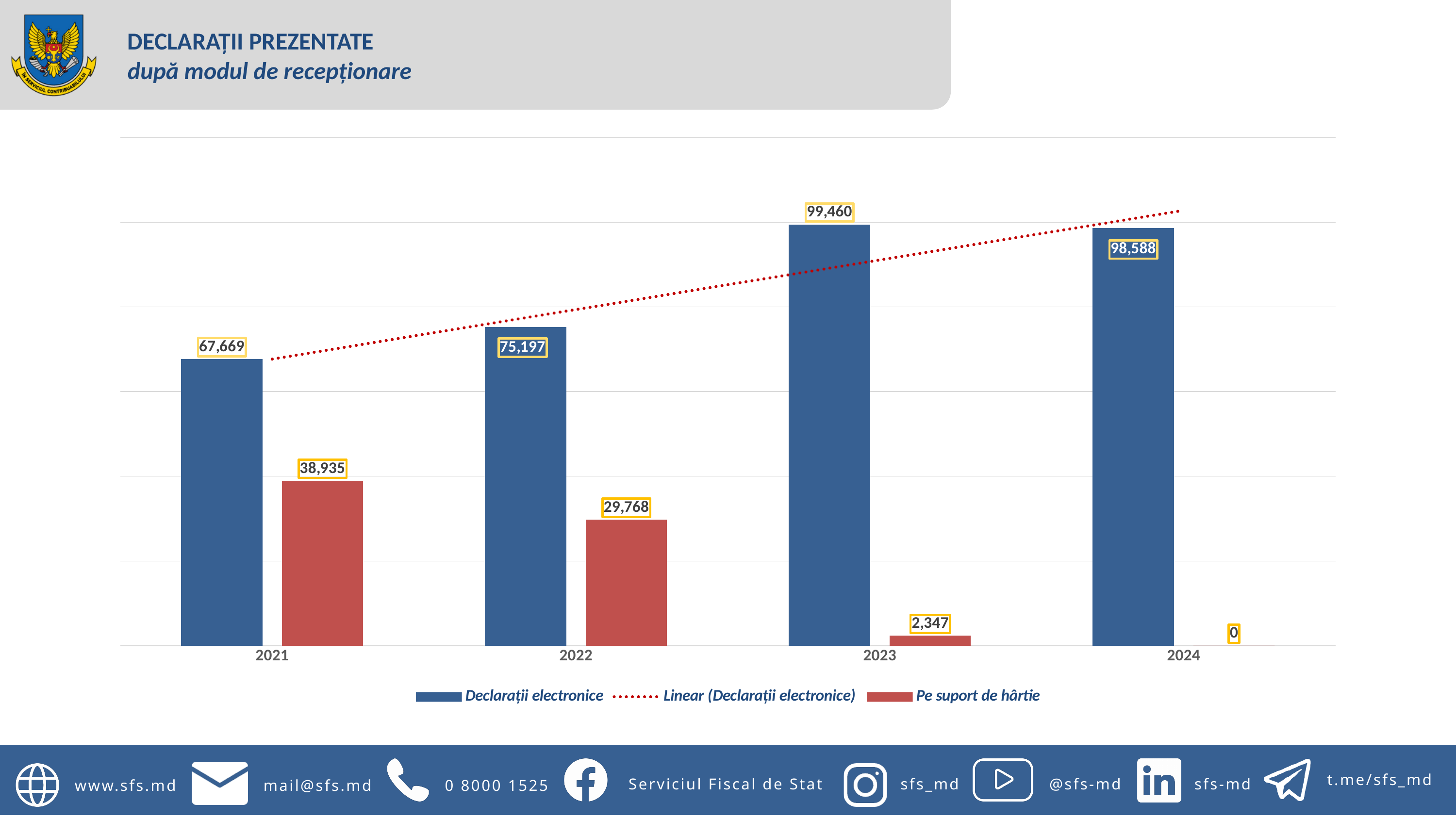
What is the value for Pe suport de hârtie in 2022? 29,768 In which year is the value for Declarații electronice highest? 2023 Do the values for Pe suport de hârtie rise or fall from 2021 to 2024? Fall What is the value for Declarații electronice in 2023? 99,460 What is the value for Pe suport de hârtie in 2024? 0 What is the value for Declarații electronice in 2021? 67,669 In which year is the value for Pe suport de hârtie lowest? 2024 What is the difference between Declarații electronice and Pe suport de hârtie in 2021? 28,734 What kind of chart is shown on the slide? Bar chart Which is larger in 2022: Declarații electronice or Pe suport de hârtie? Declarații electronice How many years are shown on the x axis? 4 How many entries does the legend list? 3